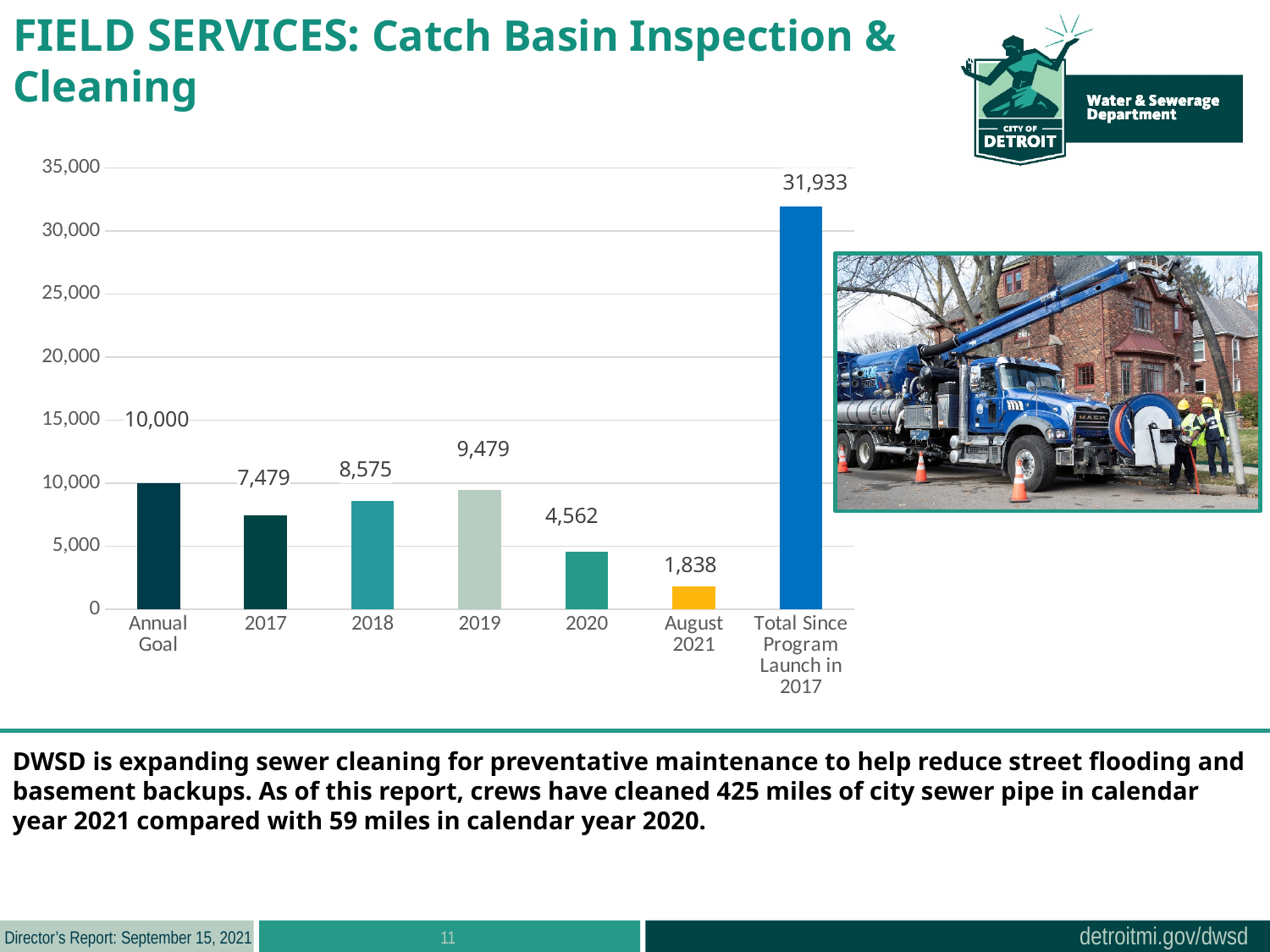
Is the value for 2020 greater or less than 5,000? less How many bars are plotted in the chart? 7 What is the difference between the Annual Goal and the 2017 value? 2,521 What value is shown for August 2021? 1,838 What is the value for Total Since Program Launch in 2017? 31,933 What is the value shown for the Annual Goal bar? 10,000 Which category has the lowest value? August 2021 What is the difference between the 2019 value and the 2020 value? 4,917 What kind of chart is shown on the slide? bar chart Which category has the highest value? Total Since Program Launch in 2017 What value is shown for 2019? 9,479 Which is larger, the value for 2018 or the value for 2017? 2018